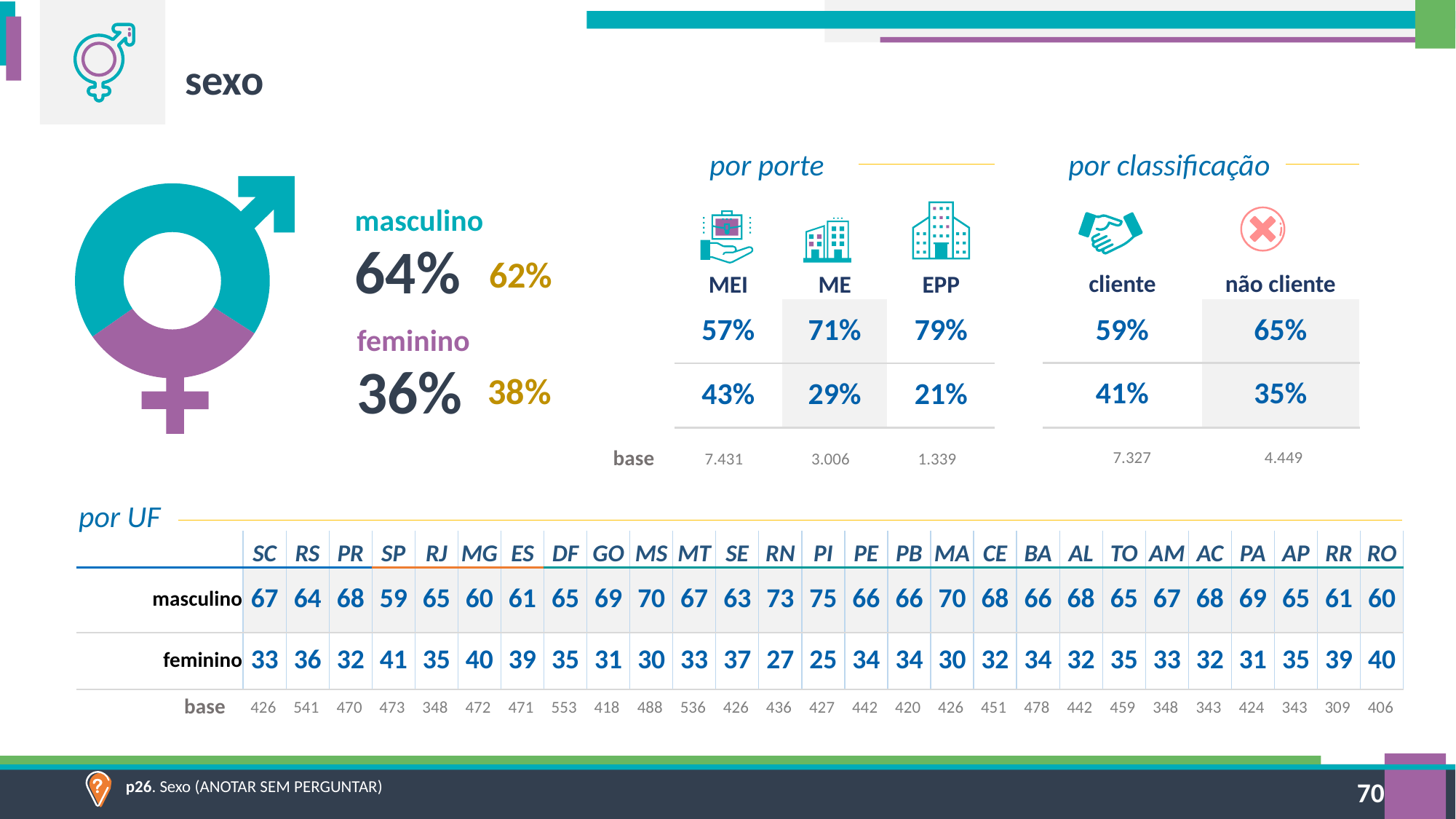
In the 'por porte' table, what is the masculino percentage for EPP? 79% In the gender chart on the left, which colour represents feminino? purple How many categories does the gender chart on the left show? 2 In the 'por UF' table, what is the feminino value for SP? 41 In the 'por porte' table, which porte has the highest feminino percentage? MEI In the gender chart on the left, which category has the larger share, masculino or feminino? masculino In the gender chart on the left, what is the difference in percentage points between masculino and feminino? 28 In the 'por UF' table, which UF has the highest masculino value? PI In the gender chart on the left, what percentage is shown for feminino? 36% In the gender chart on the left, what percentage is shown for masculino? 64% In the 'por classificação' table, what is the feminino percentage for cliente? 41% In the gender chart on the left, which colour represents masculino? teal